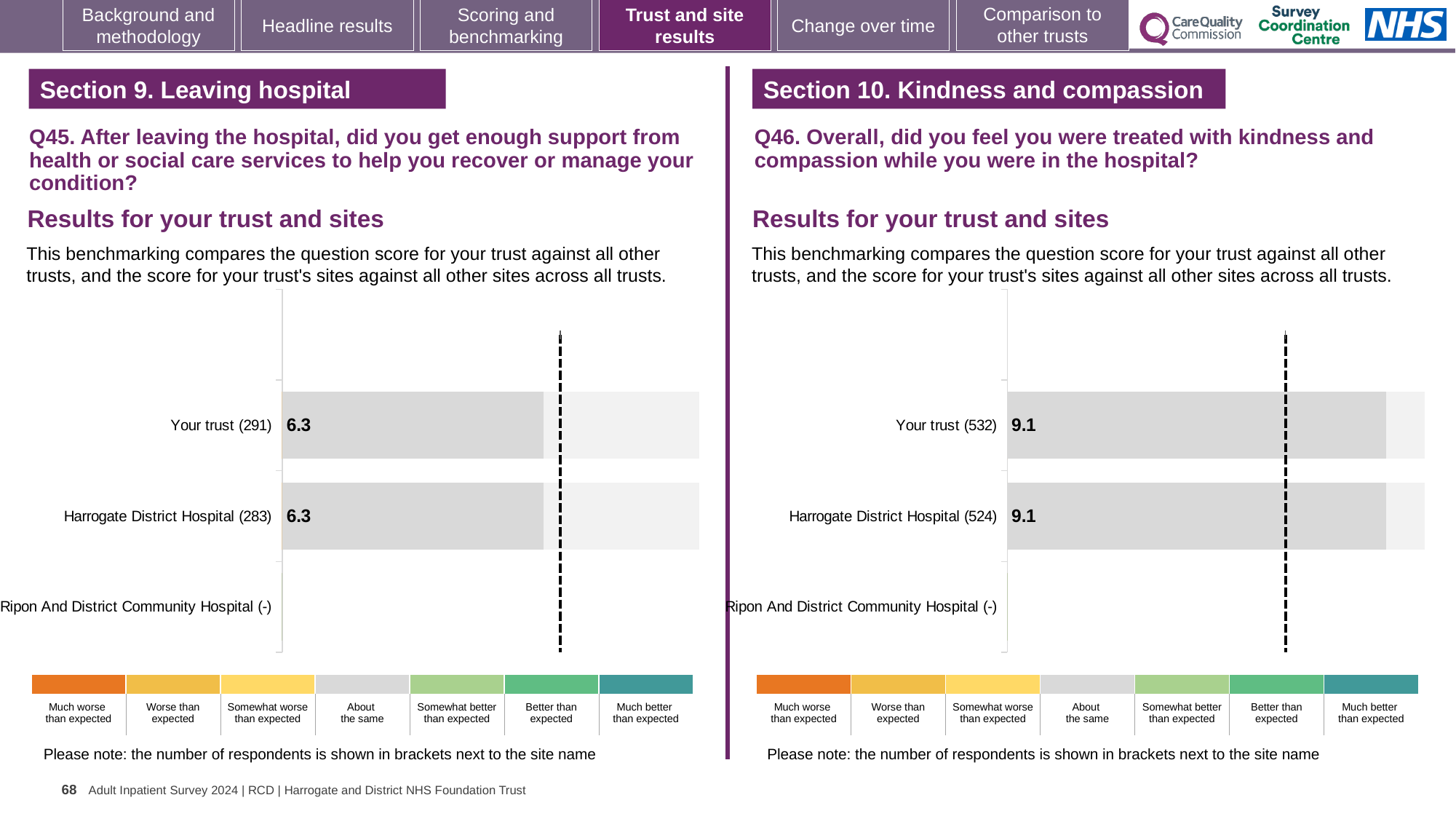
In the Q46 chart on the right, how many respondents are shown in brackets for Harrogate District Hospital? 524 In the Q45 chart on the left, what is the score for Your trust? 6.3 What is the difference between the Your trust score in the Q46 chart on the right and the Your trust score in the Q45 chart on the left? 2.8 In the Q45 chart on the left, what is the score for Harrogate District Hospital? 6.3 In the Q45 chart on the left, which category has no score shown? Ripon And District Community Hospital (-) What kind of chart is used for the Q46 results on the right? Bar chart In the Q46 chart on the right, what is the score for Harrogate District Hospital? 9.1 In the Q46 chart on the right, what is the score for Your trust? 9.1 How many rating bands are shown in the colour key below the Q46 chart on the right? 7 Which is larger: the Your trust score in the Q46 chart on the right or the Your trust score in the Q45 chart on the left? Q46 chart (9.1) How many site/trust categories are listed on the y axis of the Q45 chart on the left? 3 In the Q45 chart on the left, how many respondents are shown in brackets for Your trust? 291